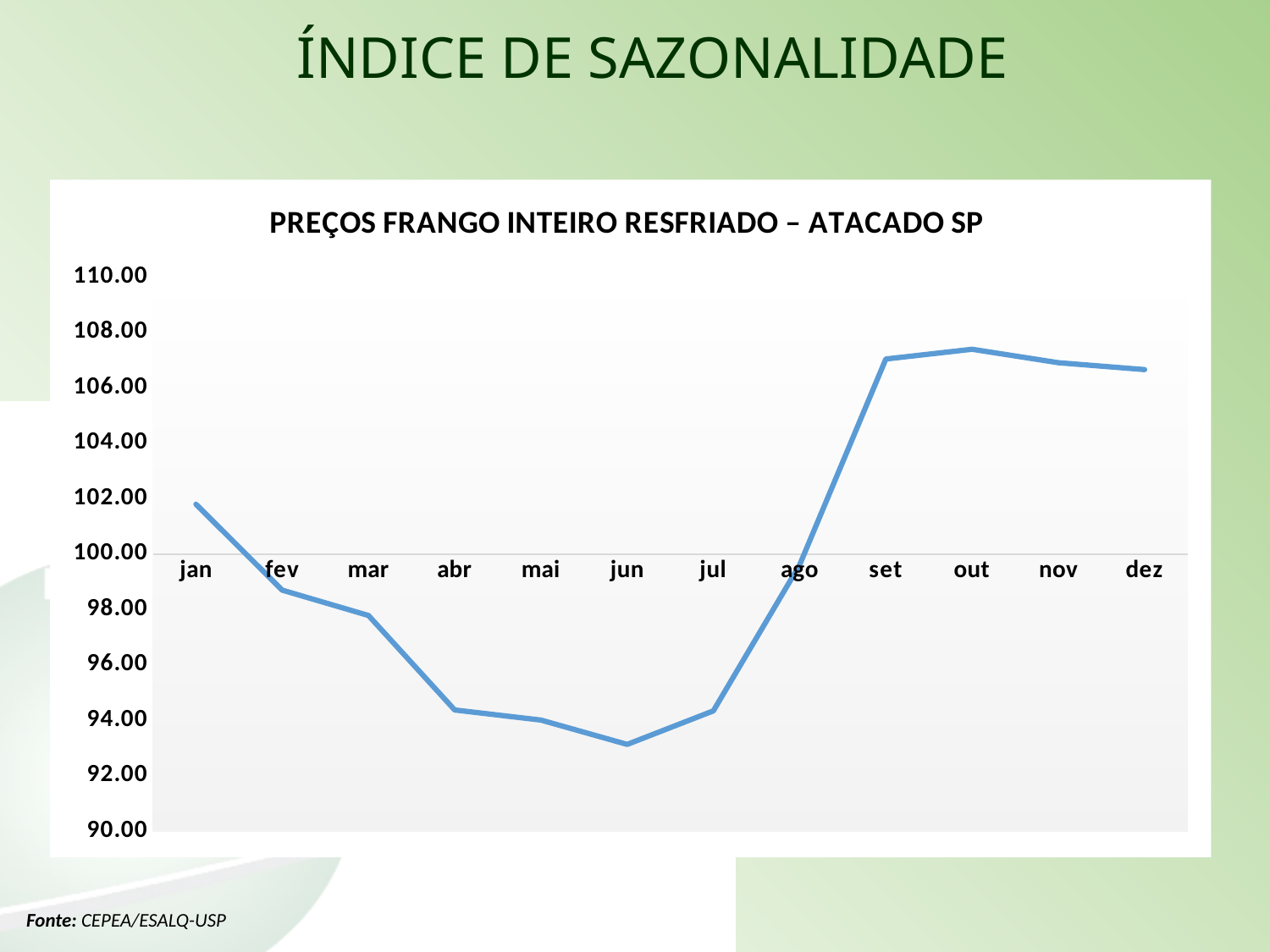
What is the title of the chart? PREÇOS FRANGO INTEIRO RESFRIADO – ATACADO SP Which is larger, the value for jan or the value for jun? jan Is the value for abr greater or less than 96.00? less Do the values rise or fall from jun to set? rise Is the value for jun greater or less than 94.00? less What type of chart is shown on the slide? line chart Is the value for jan greater or less than 100.00? greater How many months are plotted along the x axis? 12 Which month has the lowest value on the chart? jun Do the values rise or fall from jan to jun? fall